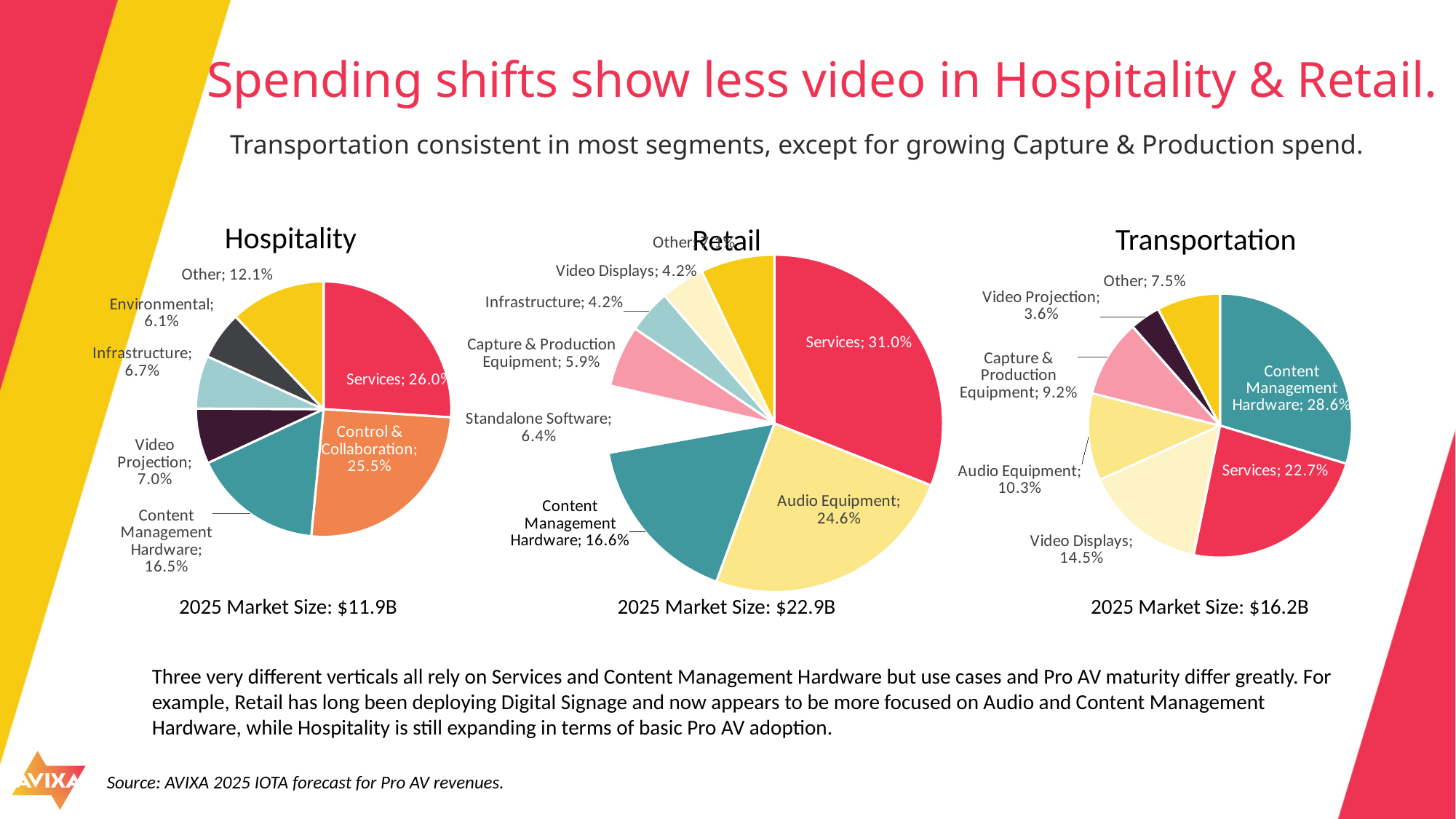
What is the 2025 market size shown under the Retail chart? $22.9B In the Hospitality chart, what is the value for Infrastructure? 6.7% In the Retail chart, what is the difference between Services and Content Management Hardware? 14.4% In the Transportation chart, which is larger: Video Displays or Audio Equipment? Video Displays In the Transportation chart, which category has the smallest share? Video Projection What type of chart is used for the Retail data? Pie chart In the Hospitality chart, what share does Services account for? 26.0% How many slices does the Hospitality pie chart have? 7 In the Transportation chart, what is the value for Content Management Hardware? 28.6% In the Retail chart, which category has the largest share? Services In the Hospitality chart, what is the difference between Services and Control & Collaboration? 0.5% In the Retail chart, what is the value for Audio Equipment? 24.6%